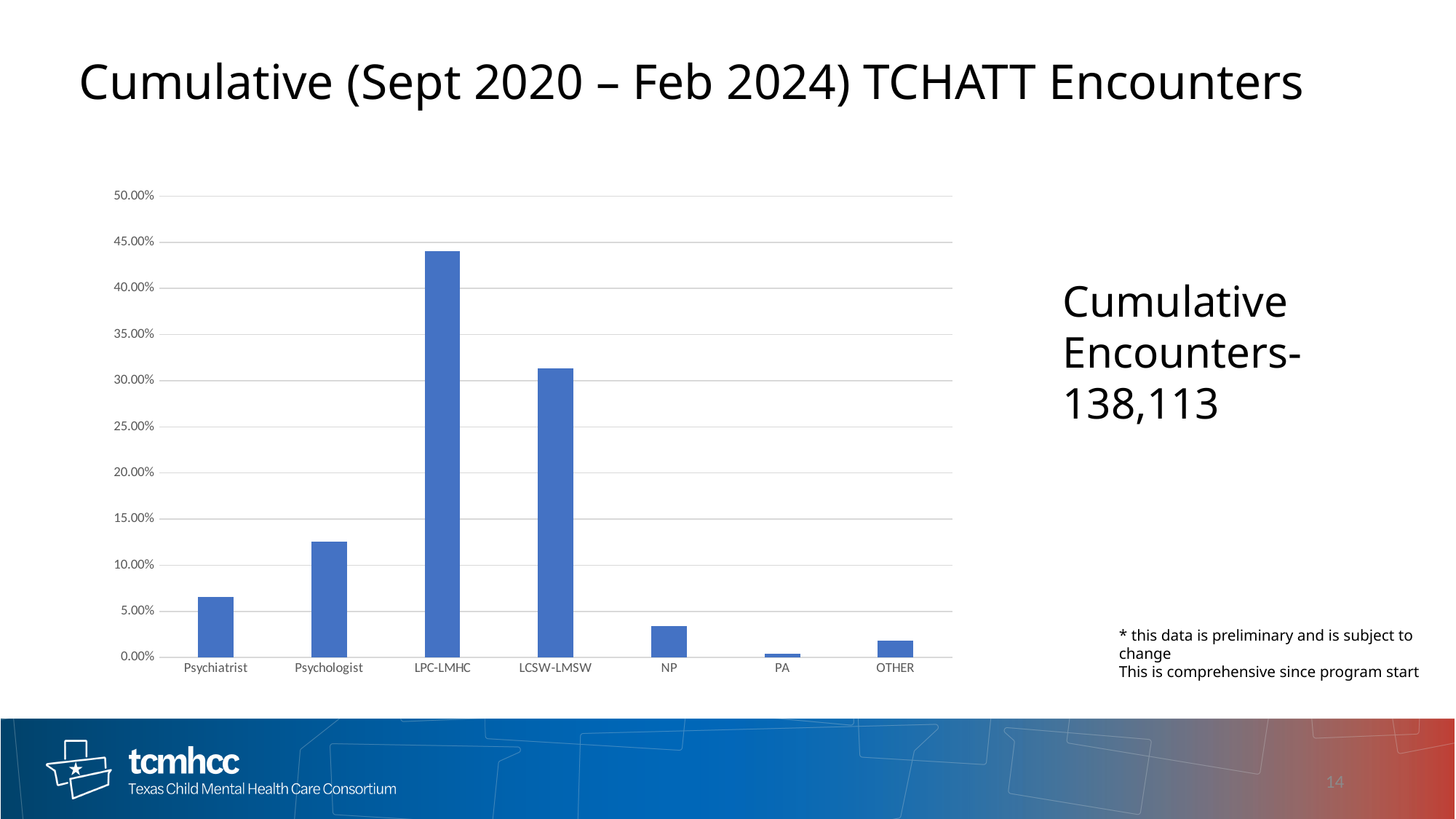
Is the value for LPC-LMHC greater or less than 40.00%? greater Is the value for Psychologist greater or less than 10.00%? greater Which category has the highest value in the chart? LPC-LMHC Is the value for Psychiatrist greater or less than 10.00%? less Which is larger, the value for Psychologist or the value for Psychiatrist? Psychologist Which is larger, the value for NP or the value for OTHER? NP Which category has the lowest value in the chart? PA How many provider categories are shown on the x axis of the chart? 7 What is the total number of cumulative encounters stated on the slide? 138,113 What kind of chart is shown on the slide? bar chart